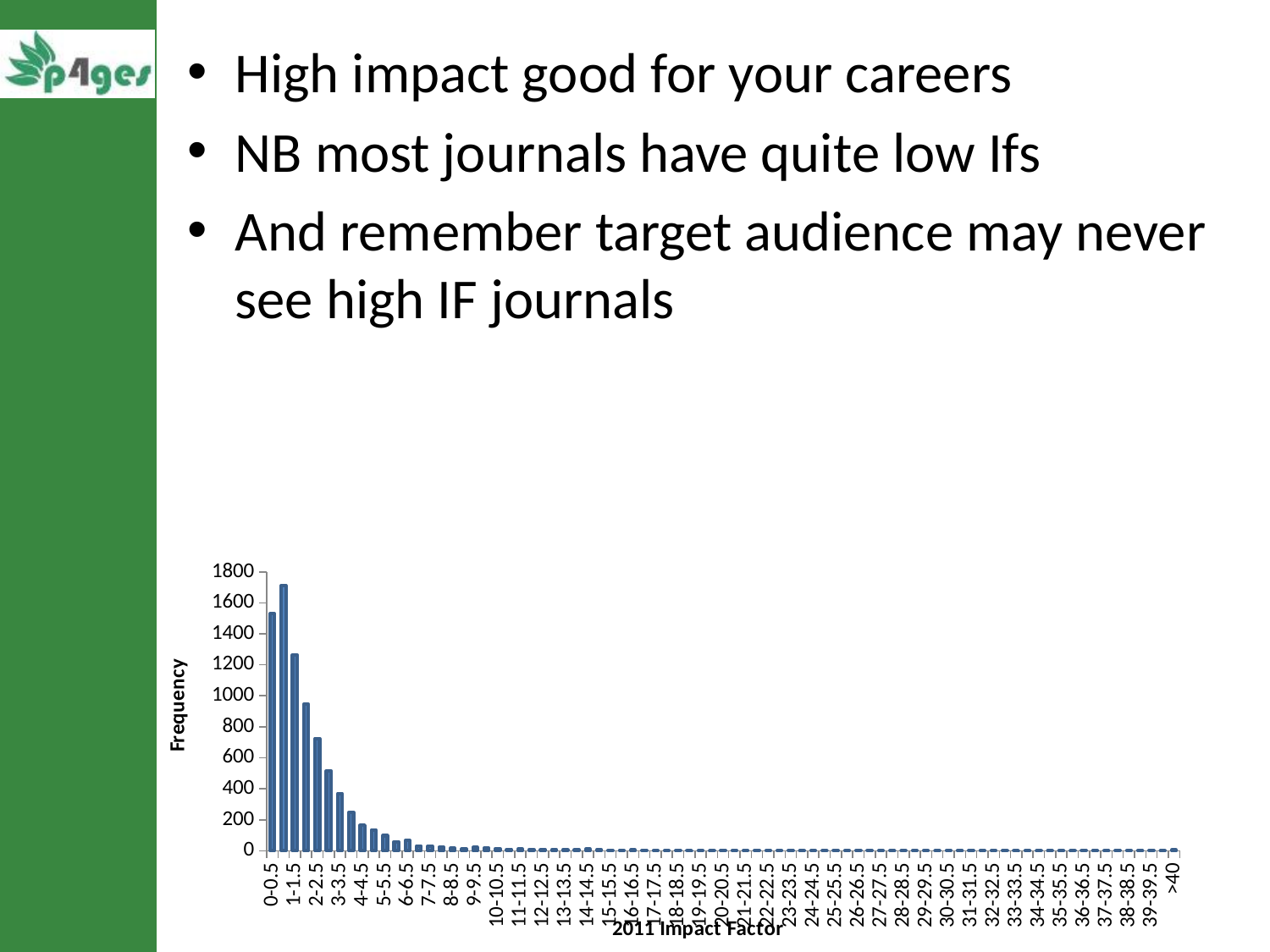
Is the frequency for the 3-3.5 impact factor bin greater or less than 600? less Is the frequency for the 5-5.5 impact factor bin greater or less than 200? less What is the title of the vertical axis of the chart? Frequency Is the frequency for the 2-2.5 impact factor bin greater or less than 600? greater Which has the higher frequency, the 0-0.5 bin or the 1-1.5 bin? 0-0.5 What kind of chart is shown on the slide? bar chart What is the title of the horizontal axis of the chart? 2011 Impact Factor Do the frequencies generally rise or fall as the impact factor increases along the x axis? fall Which has the higher frequency, the 2-2.5 bin or the 4-4.5 bin? 2-2.5